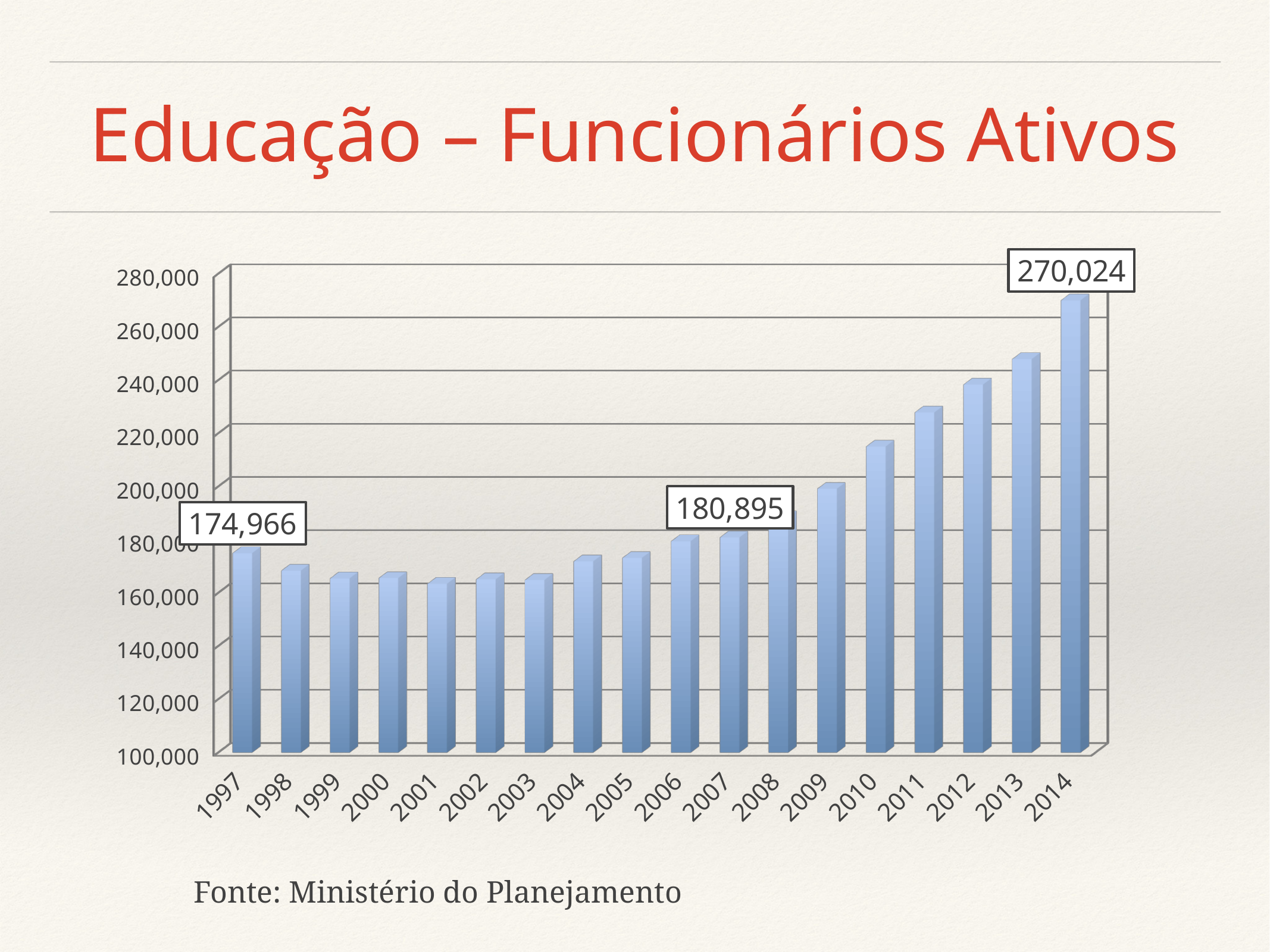
What is the title of the slide? Educação – Funcionários Ativos How many years are shown on the x axis? 18 Is the value for 2001 greater or less than 180,000? less What is the difference between the values for 2014 and 1997? 95,058 Which year has the highest value? 2014 Is the value for 2012 greater or less than 220,000? greater What kind of chart is shown on the slide? bar chart What is the value for 1997? 174,966 Is the value for 2009 greater or less than 180,000? greater Which is larger, the value for 2010 or the value for 2005? 2010 Do the values rise or fall from 2003 to 2014? rise What is the value for 2014? 270,024